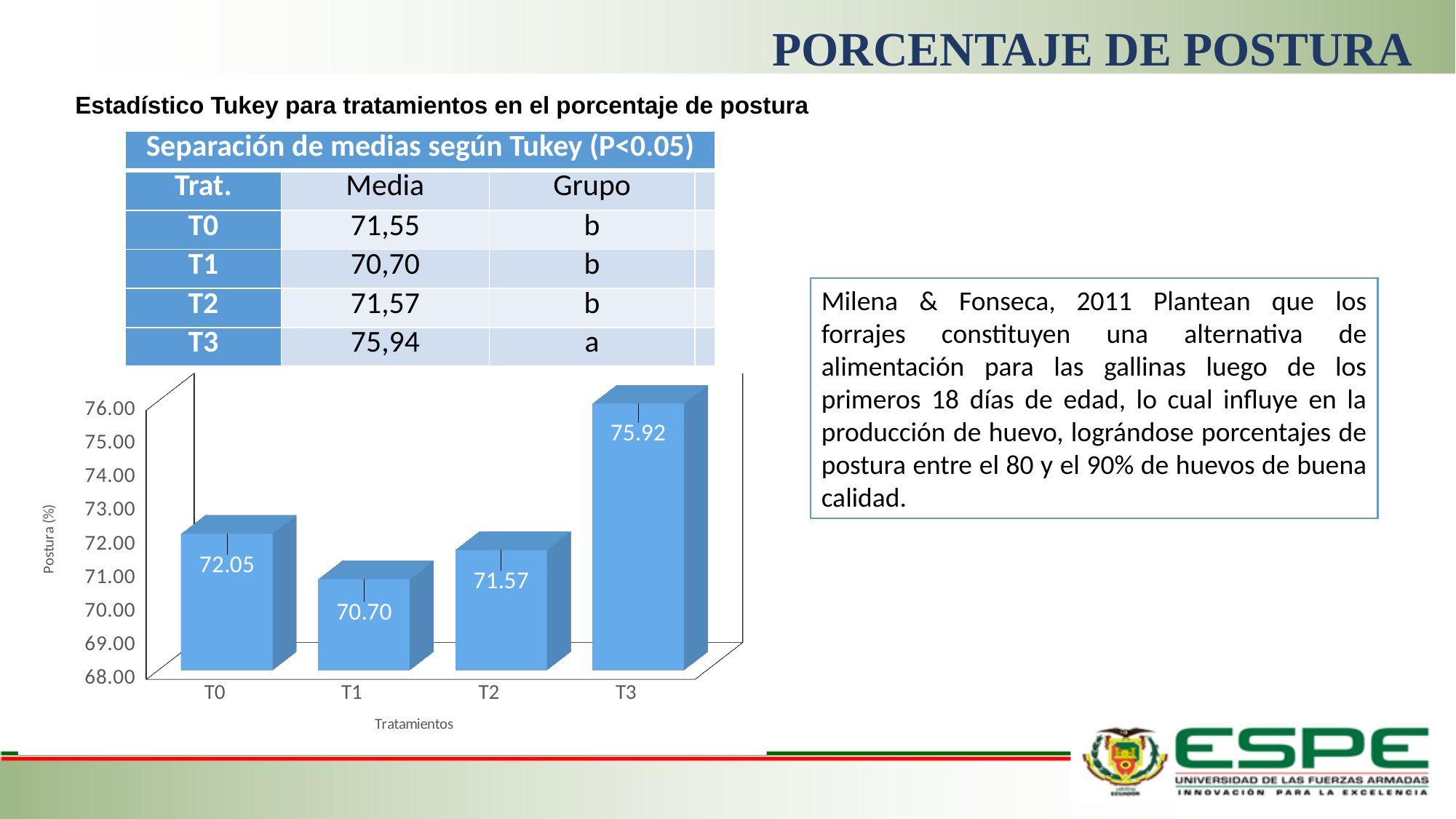
What is the value plotted for T1 in the bar chart? 70.70 How many treatments are plotted on the x axis of the bar chart? 4 What is the value plotted for T0 in the bar chart? 72.05 Which treatment has the lowest bar in the chart? T1 In the bar chart, which is larger, the value for T0 or the value for T2? T0 Is the value for T3 in the bar chart greater or less than 74.00? greater What is the difference between the values for T3 and T1 in the bar chart? 5.22 What is the value plotted for T3 in the bar chart? 75.92 Which treatment has the highest bar in the chart? T3 What is the label of the vertical axis of the bar chart? Postura (%) What kind of chart is shown on the slide? Bar chart What is the difference between the values for T0 and T2 in the bar chart? 0.48